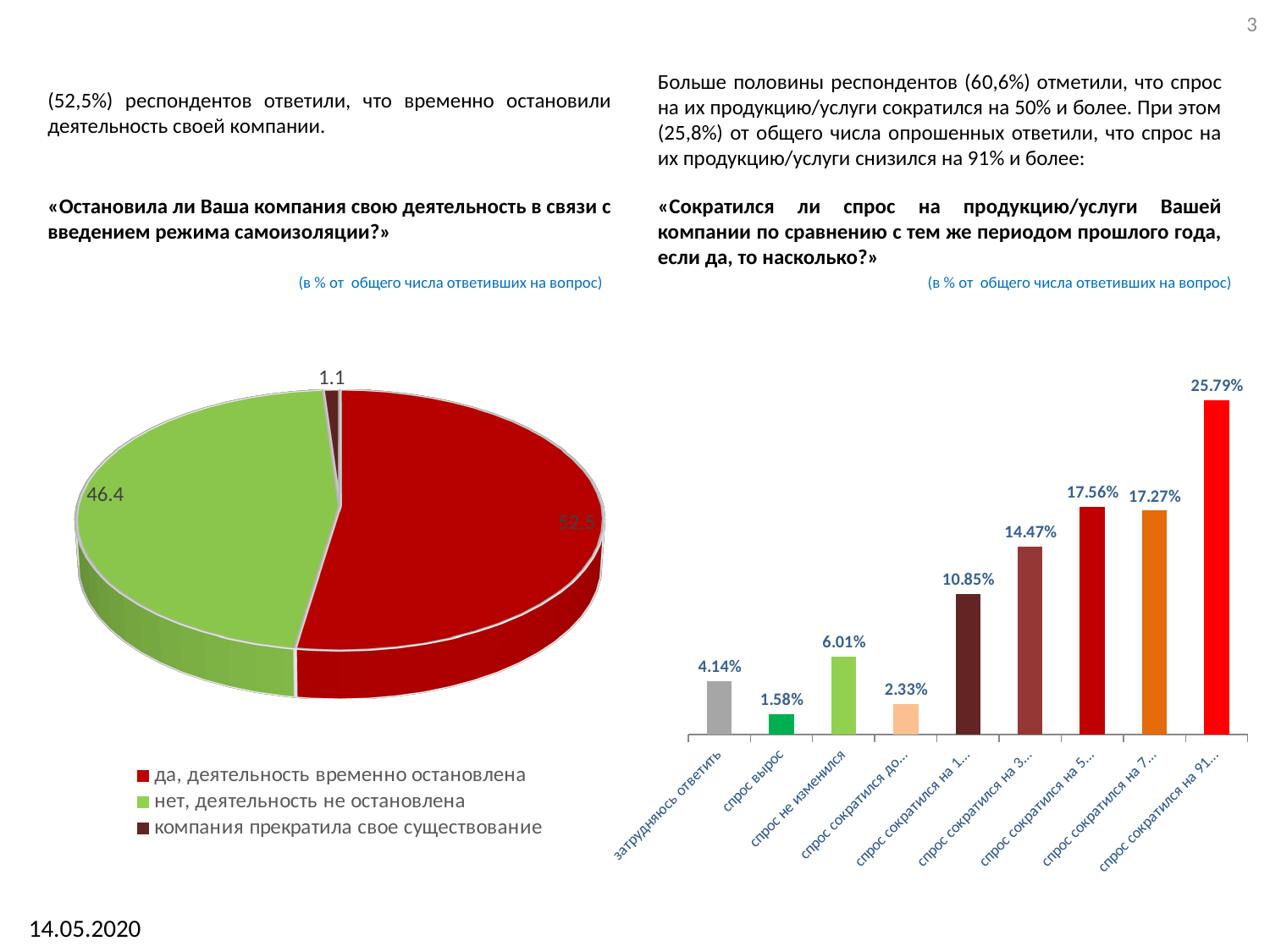
On the left chart (pie), how many categories does the legend list? 3 On the left chart (pie), what value is shown for «нет, деятельность не остановлена»? 46.4 On the right chart (bar chart), what is the difference between the highest bar (25.79%) and the «затрудняюсь ответить» bar? 21.65% On the right chart (bar chart), which category has the highest value? спрос сократился на 91… On the left chart (pie), what is the difference between the «да, деятельность временно остановлена» and «нет, деятельность не остановлена» slices? 6.1 On the right chart (bar chart), what is the value for «затрудняюсь ответить»? 4.14% On the right chart (bar chart), which category has the lowest value? спрос вырос On the left chart (pie), which category has the smallest slice? компания прекратила свое существование What type of chart is shown on the left side of the slide? pie chart On the right chart (bar chart), what is the value for «спрос не изменился»? 6.01% On the left chart (pie), what percentage of respondents answered «да, деятельность временно остановлена»? 52.5 On the right chart (bar chart), how many bars are plotted? 9